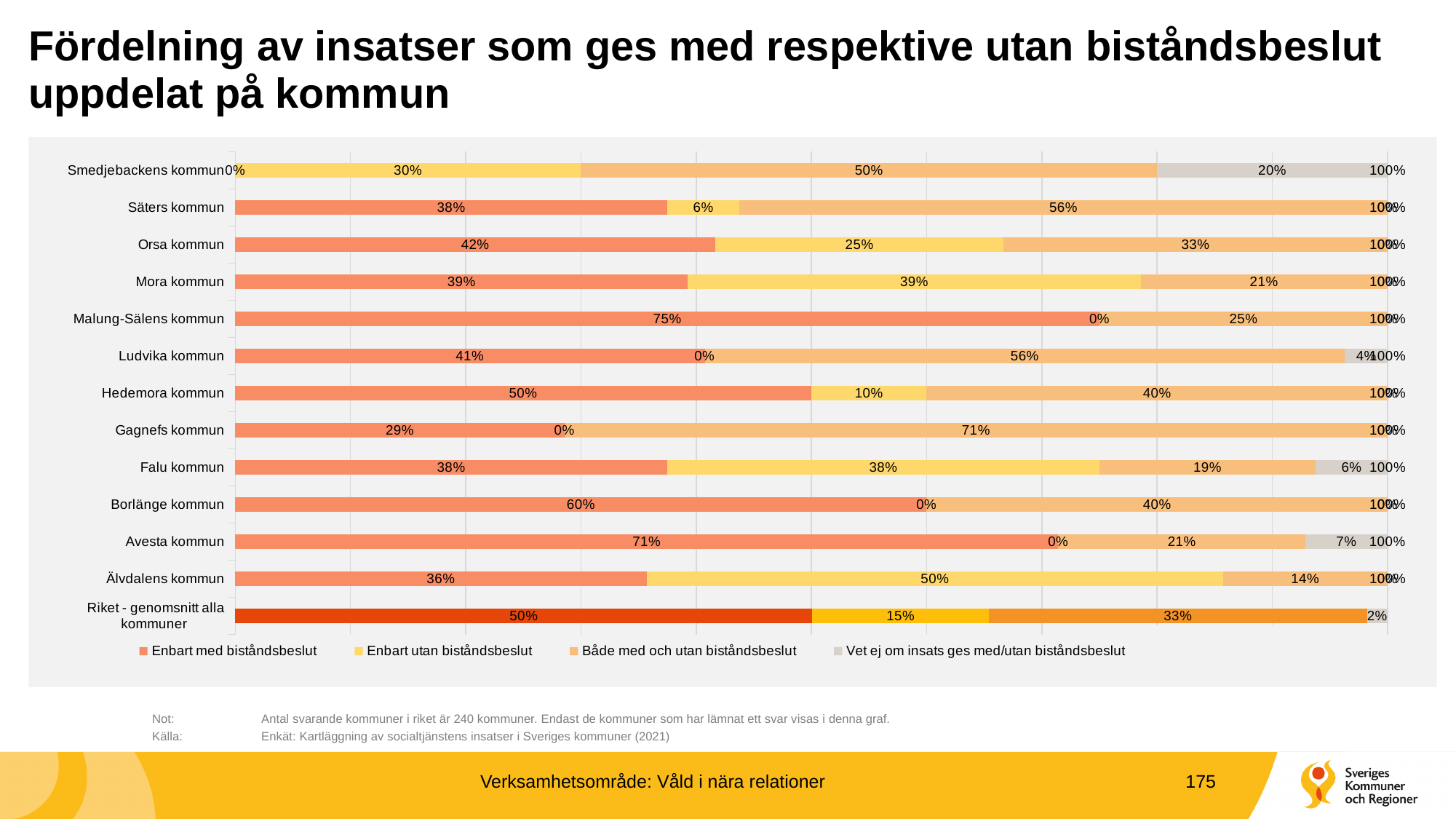
What is the difference between the 'Enbart med biståndsbeslut' values for Orsa kommun and Mora kommun? 3 percentage points What is the value for 'Både med och utan biståndsbeslut' for Gagnefs kommun? 71% How many categories (rows) are shown in the chart? 13 Which municipality has the lowest value for 'Både med och utan biståndsbeslut'? Älvdalens kommun What is the 'Enbart utan biståndsbeslut' value for 'Riket - genomsnitt alla kommuner'? 15% What is the value for 'Enbart utan biståndsbeslut' for Älvdalens kommun? 50% What kind of chart is shown on the slide? Stacked bar chart What is the value for 'Enbart med biståndsbeslut' for Malung-Sälens kommun? 75% What is the value for 'Vet ej om insats ges med/utan biståndsbeslut' for Smedjebackens kommun? 20% Which has a larger 'Enbart med biståndsbeslut' value, Avesta kommun or Borlänge kommun? Avesta kommun How many series does the legend list? 4 Which municipality has the highest value for 'Enbart med biståndsbeslut'? Malung-Sälens kommun